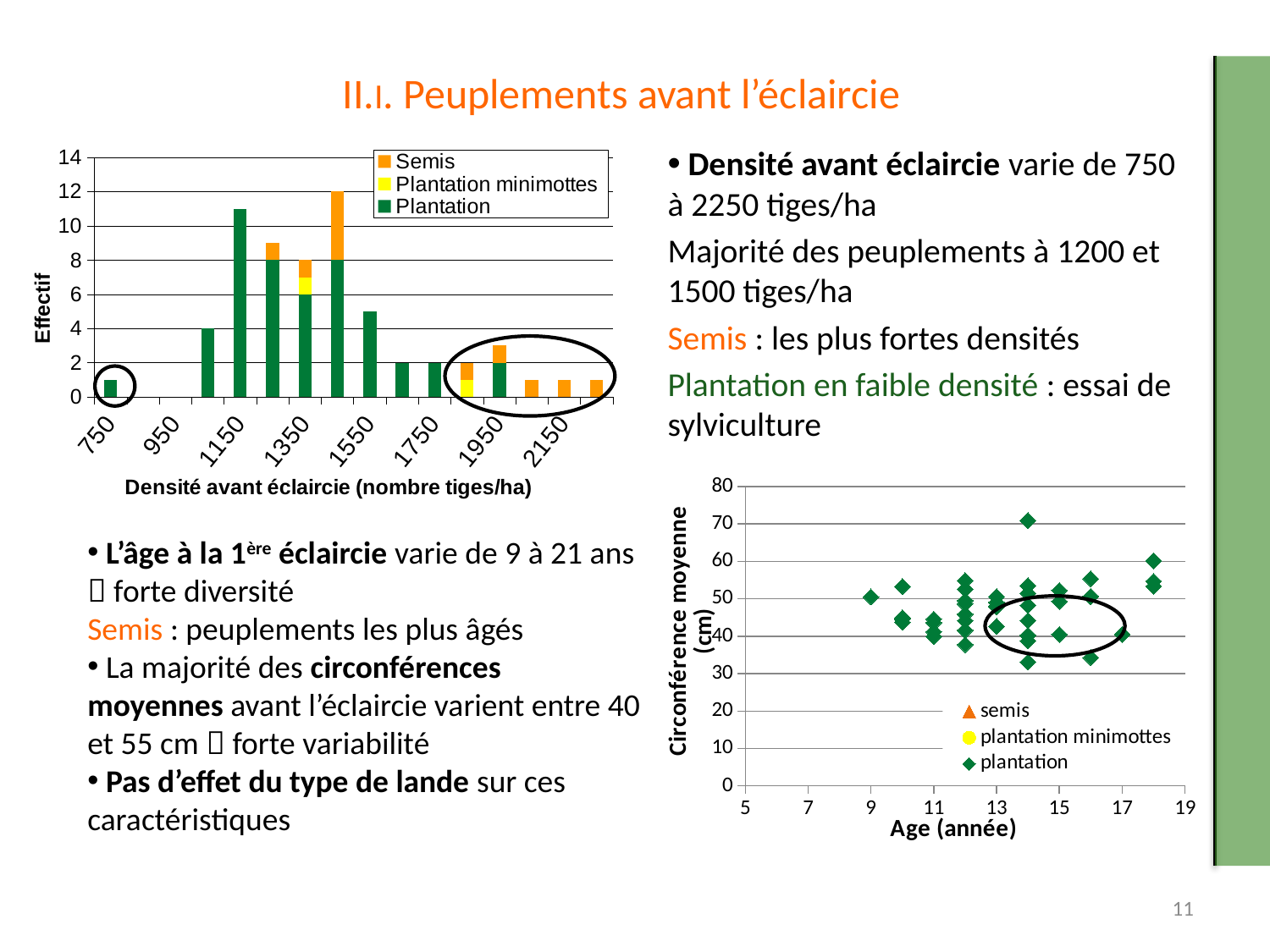
In the top-left bar chart, what is the value (Effectif) for the bar at 1750 tiges/ha? 2 In the bottom-right scatter chart, how many series does the legend list? 3 In the top-left bar chart, what is the total height of the stacked bar at 1350 tiges/ha? 8 What kind of chart is the top-left chart with the x-axis 'Densité avant éclaircie (nombre tiges/ha)'? Stacked bar chart In the top-left bar chart, how many series does the legend list? 3 What kind of chart is the bottom-right chart with the x-axis 'Age (année)'? Scatter chart In the top-left bar chart, is the value for 750 tiges/ha greater or less than 2? less In the top-left bar chart, which bar is taller: 1150 tiges/ha or 1350 tiges/ha? 1150 tiges/ha In the top-left bar chart, which series is shown in orange in the legend? Semis In the top-left bar chart, is the total value for 1550 tiges/ha greater or less than 4? greater In the bottom-right scatter chart, is the highest plantation point (at age 14) greater or less than 60 cm? greater